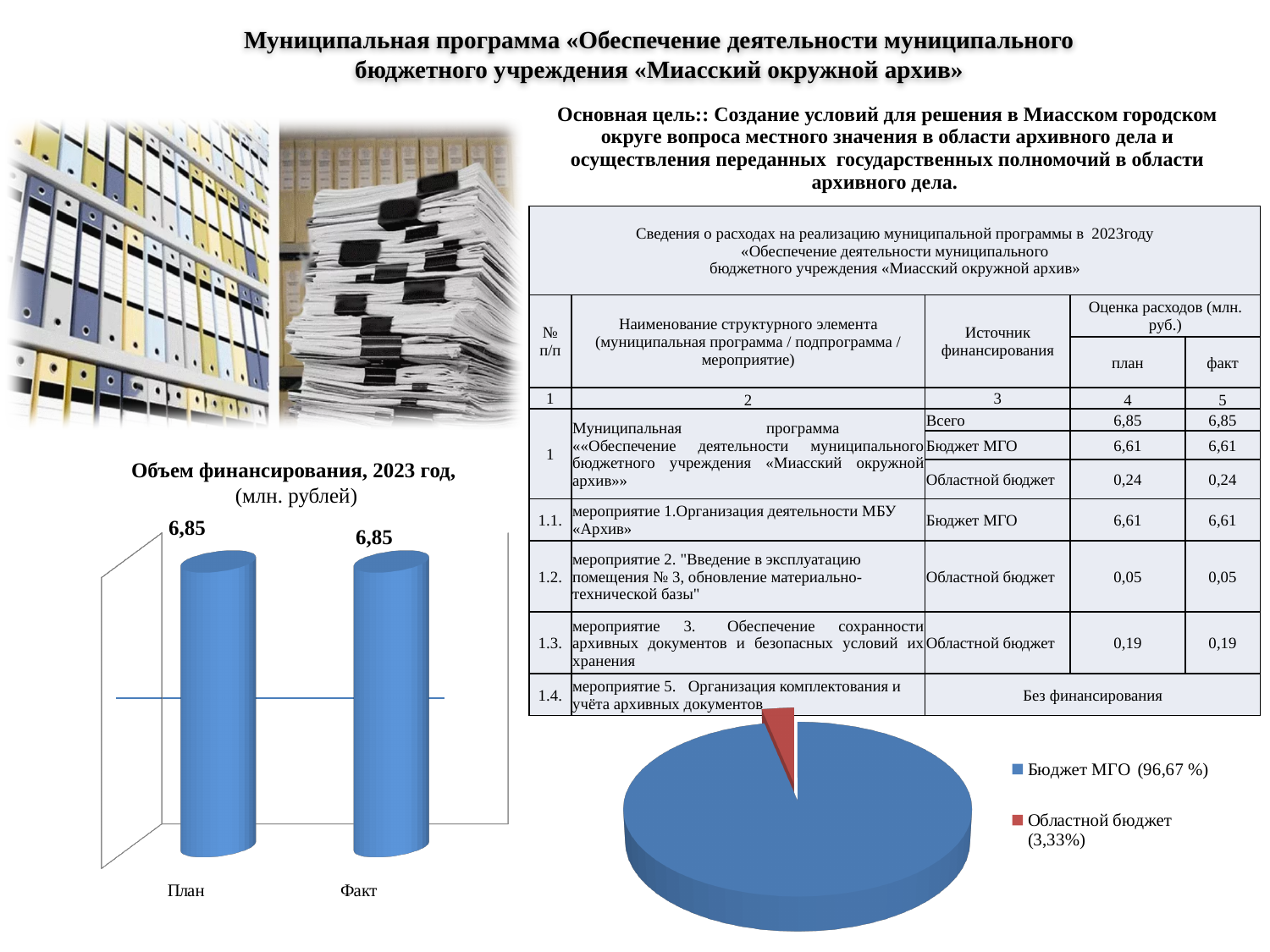
In the chart titled "Объем финансирования, 2023 год", how many categories are shown on the x axis? 2 In the pie chart at the bottom right of the slide, which slice is the smallest? Областной бюджет In the chart titled "Объем финансирования, 2023 год", what unit is given in the title? млн. рублей What kind of chart is the one titled "Объем финансирования, 2023 год"? Bar chart In the pie chart at the bottom right of the slide, how many entries does the legend list? 2 In the chart titled "Объем финансирования, 2023 год", what is the value for План? 6,85 In the pie chart at the bottom right of the slide, which slice is the largest? Бюджет МГО In the chart titled "Объем финансирования, 2023 год", what is the value for Факт? 6,85 In the chart titled "Объем финансирования, 2023 год", what is the difference between the План and Факт values? 0 What kind of chart is the one at the bottom right of the slide? Pie chart In the pie chart at the bottom right of the slide, what share does Бюджет МГО have? 96,67 % In the pie chart at the bottom right of the slide, what share does Областной бюджет have? 3,33%